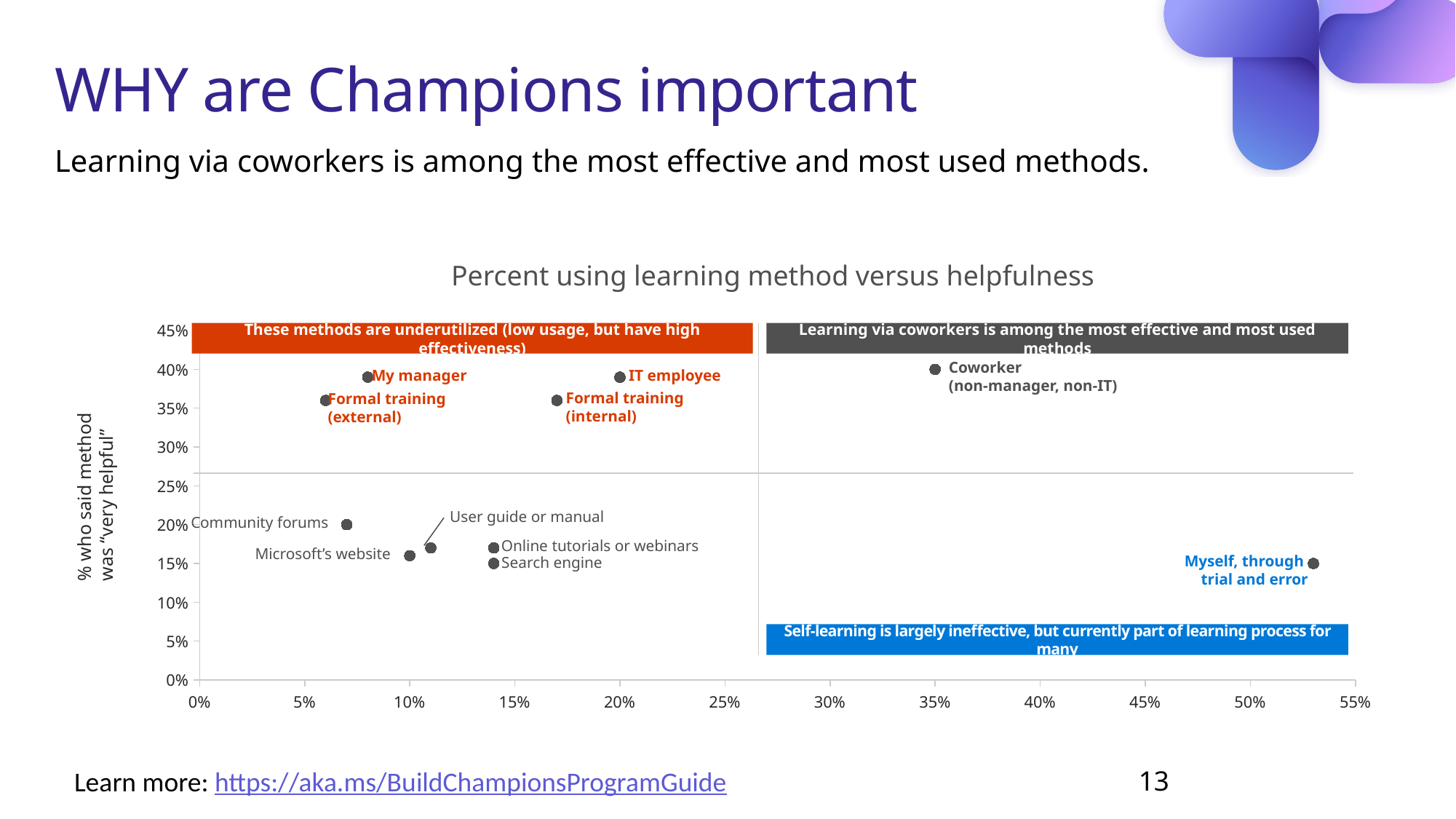
Is the percent usage for 'Myself, through trial and error' greater or less than 50%? greater Which has a higher percent usage: 'IT employee' or 'My manager'? IT employee What is the title of the chart? Percent using learning method versus helpfulness Which has a higher helpfulness value: 'Coworker (non-manager, non-IT)' or 'Community forums'? Coworker (non-manager, non-IT) Is the helpfulness value for 'My manager' greater or less than 35%? greater What kind of chart is shown on the slide? scatter chart Is the percent usage for 'Coworker (non-manager, non-IT)' greater or less than 30%? greater Which learning method has the highest percent usage (furthest right on the x axis)? Myself, through trial and error What is the label on the chart's y axis? % who said method was "very helpful" How many learning methods are plotted as points on the chart? 11